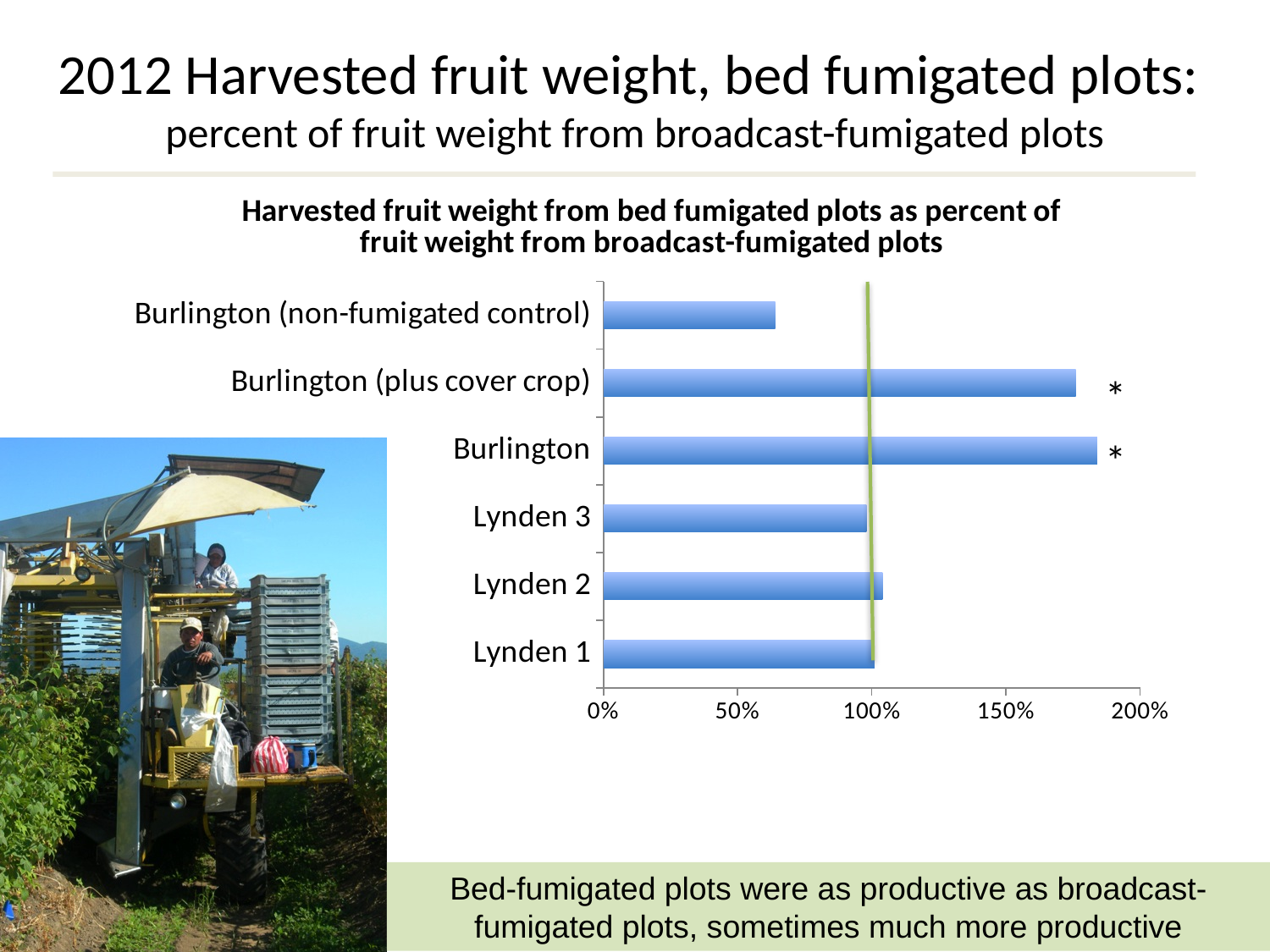
How many categories are plotted in the chart? 6 At what axis value is the green vertical reference line drawn in the chart? 100% Which category has the lowest value in the chart? Burlington (non-fumigated control) Is the value for Burlington (plus cover crop) greater or less than 150%? greater Which is larger, the value for Burlington (plus cover crop) or the value for Lynden 3? Burlington (plus cover crop) Is the value for Burlington greater or less than 150%? greater What is the title of the chart? Harvested fruit weight from bed fumigated plots as percent of fruit weight from broadcast-fumigated plots Which is larger, the value for Burlington or the value for Burlington (non-fumigated control)? Burlington Is the value for Burlington (non-fumigated control) greater or less than 100%? less What kind of chart is shown on the slide? Bar chart Which category has the highest value in the chart? Burlington